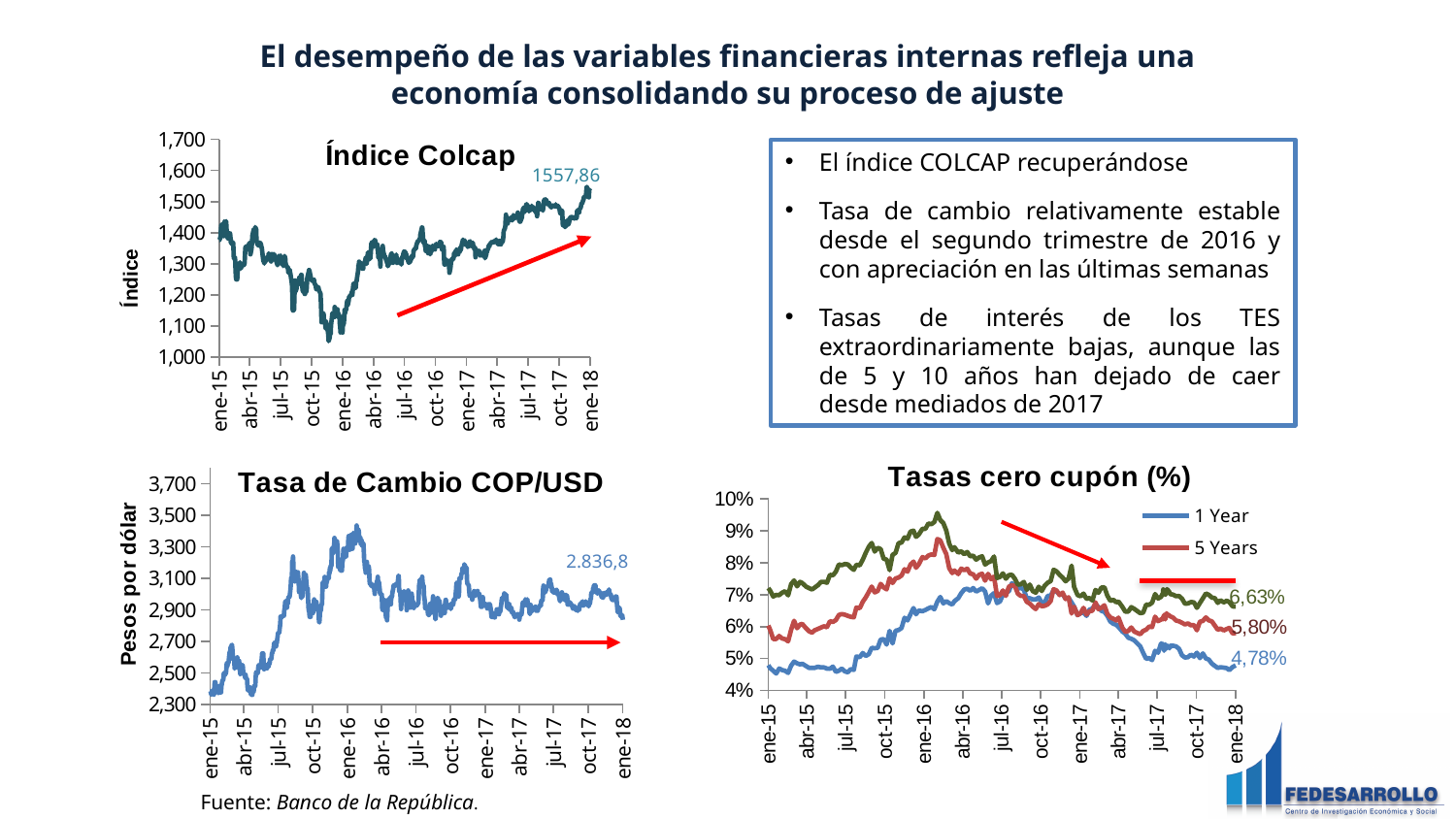
In the Tasas cero cupón (%) chart, which series has the larger final labelled value, 1 Year or 5 Years? 5 Years In the Tasa de Cambio COP/USD chart, is the value at ene-15 greater or less than 2,500? less In the Tasas cero cupón (%) chart, which series has the lowest value at ene-18? 1 Year In the Índice Colcap chart, is the lowest value of the index around ene-16 greater or less than 1,100? less In the Tasas cero cupón (%) chart, what is the final labelled value of the 1 Year series? 4,78% What is the y-axis label of the Tasa de Cambio COP/USD chart? Pesos por dólar In the Tasa de Cambio COP/USD chart, what is the value shown by the data label at the end of the series? 2.836,8 In the Índice Colcap chart, what is the value shown by the data label at the end of the series (ene-18)? 1557,86 In the Índice Colcap chart, does the index rise or fall between abr-16 and ene-18? rise In the Tasas cero cupón (%) chart, what is the final labelled value of the 5 Years series? 5,80% In the Tasas cero cupón (%) chart, what is the difference between the final labelled values of the 5 Years series (5,80%) and the 1 Year series (4,78%)? 1,02% What kind of chart is the Índice Colcap chart? line chart